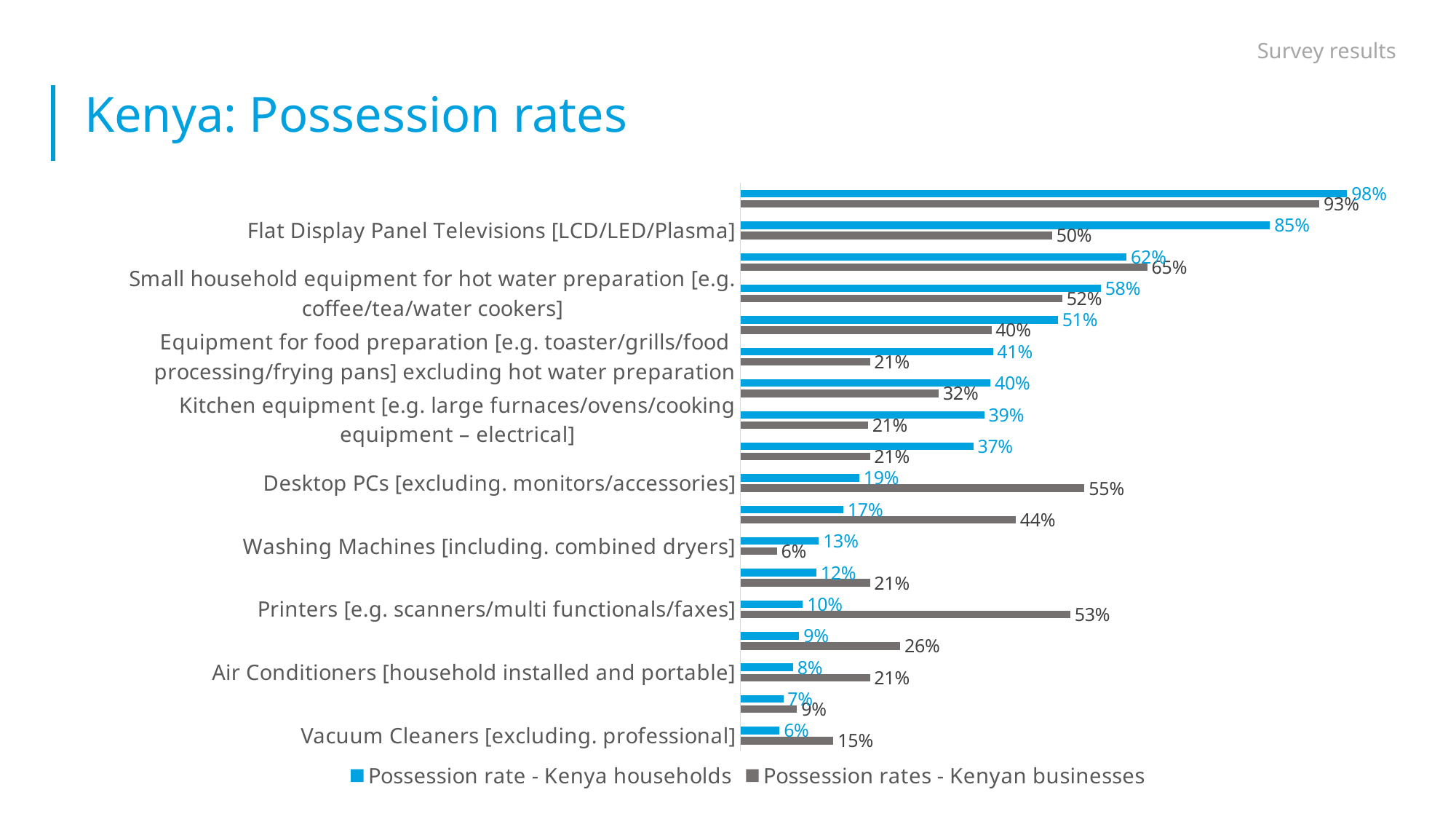
What is the difference between the Kenya households rate and the Kenyan businesses rate for Equipment for food preparation [e.g. toaster/grills/food processing/frying pans] excluding hot water preparation? 20% What is the difference between the Kenyan businesses rate and the Kenya households rate for Desktop PCs [excluding. monitors/accessories]? 36% What colour represents the Possession rate - Kenya households series? blue How many series does the legend list? 2 What is the possession rate for Kenya households for Flat Display Panel Televisions [LCD/LED/Plasma]? 85% What is the highest possession rate shown for Kenya households on the chart? 98% Which is larger for Vacuum Cleaners [excluding. professional]: the Kenya households rate or the Kenyan businesses rate? Kenyan businesses rate What is the possession rate for Kenyan businesses for Desktop PCs [excluding. monitors/accessories]? 55% What is the possession rate for Kenyan businesses for Flat Display Panel Televisions [LCD/LED/Plasma]? 50% What type of chart is shown on the slide? bar chart What is the possession rate for Kenya households for Washing Machines [including. combined dryers]? 13% What is the possession rate for Kenyan businesses for Printers [e.g. scanners/multi functionals/faxes]? 53%